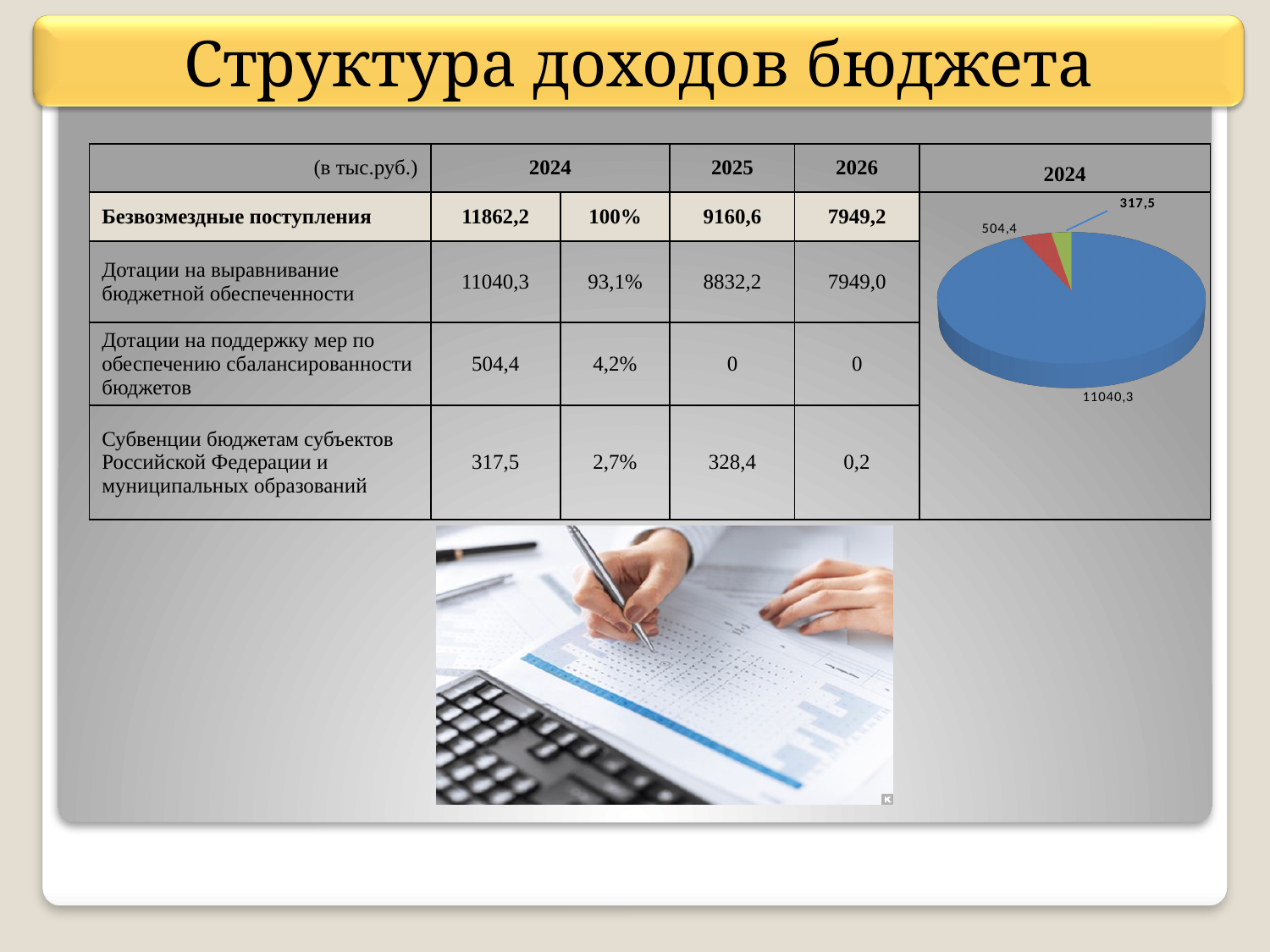
What share of the pie does the slice labelled 317,5 represent? 2,7% What share of the pie does the slice labelled 11040,3 represent? 93,1% What colour is the largest slice of the pie chart? blue How many slices does the pie chart have? 3 What is the total of all three slices in the pie chart? 11862,2 What is the difference between the largest slice (11040,3) and the slice labelled 504,4? 10535,9 What is the difference between the slices labelled 504,4 and 317,5? 186,9 What is the title of the pie chart? 2024 What is the value of the smallest slice in the pie chart? 317,5 What kind of chart is shown on the slide? pie chart What is the value of the largest slice in the pie chart? 11040,3 Which is larger in the pie chart: the slice labelled 504,4 or the slice labelled 317,5? 504,4